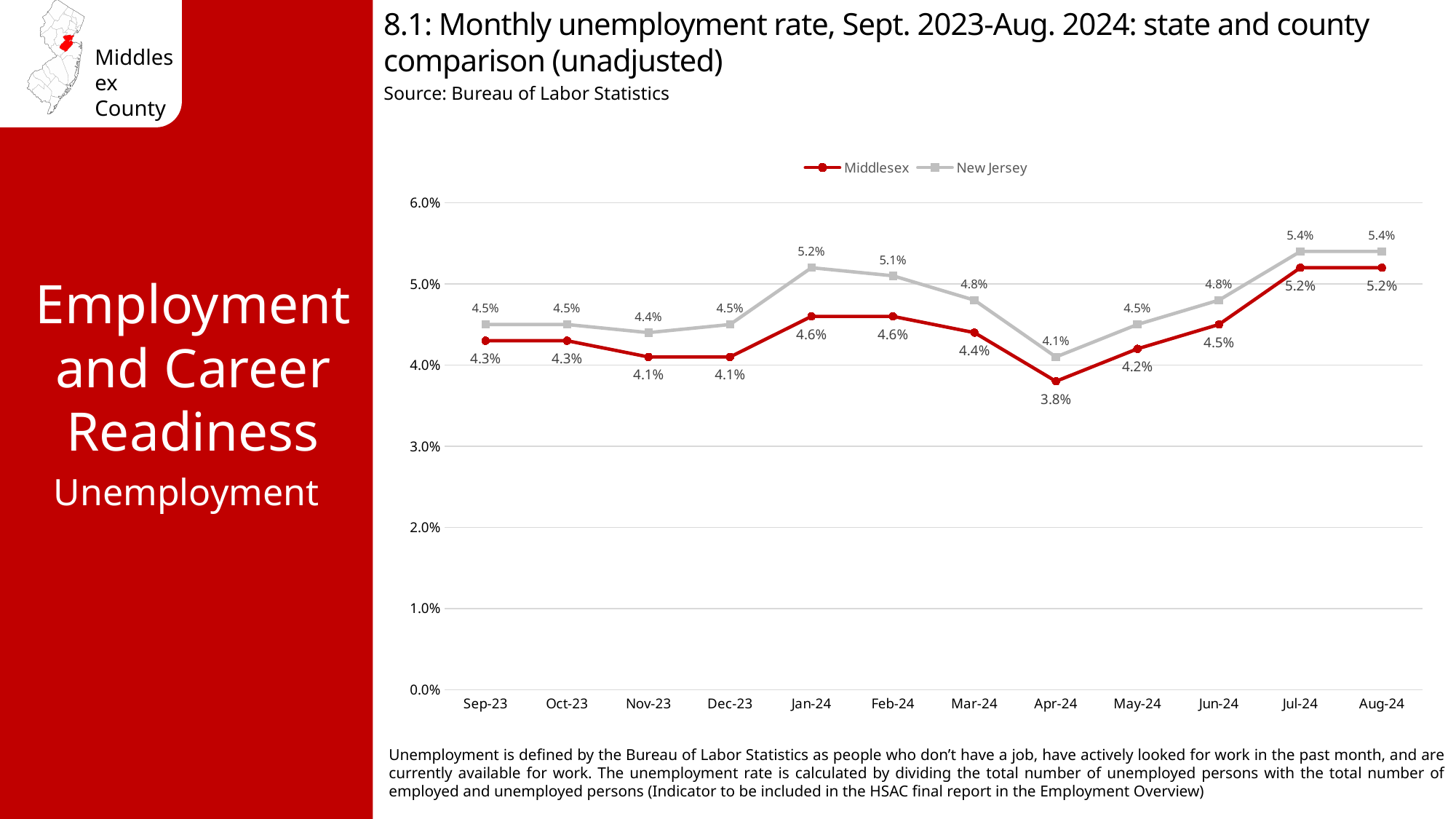
What is the difference between the New Jersey and Middlesex unemployment rates in Jan-24? 0.6% How many series does the legend list? 2 What was the Middlesex unemployment rate in Aug-24? 5.2% Is the Middlesex unemployment rate in Jul-24 greater or less than 5.0%? greater Which had the higher unemployment rate in Mar-24, Middlesex or New Jersey? New Jersey What is the highest New Jersey unemployment rate shown on the chart? 5.4% What was the New Jersey unemployment rate in Jan-24? 5.2% What was the Middlesex unemployment rate in Apr-24? 3.8% In which month was the Middlesex unemployment rate lowest? Apr-24 Did the Middlesex unemployment rate rise or fall from Apr-24 to Jul-24? Rise How many months are shown on the x axis? 12 What kind of chart is shown on the slide? Line chart